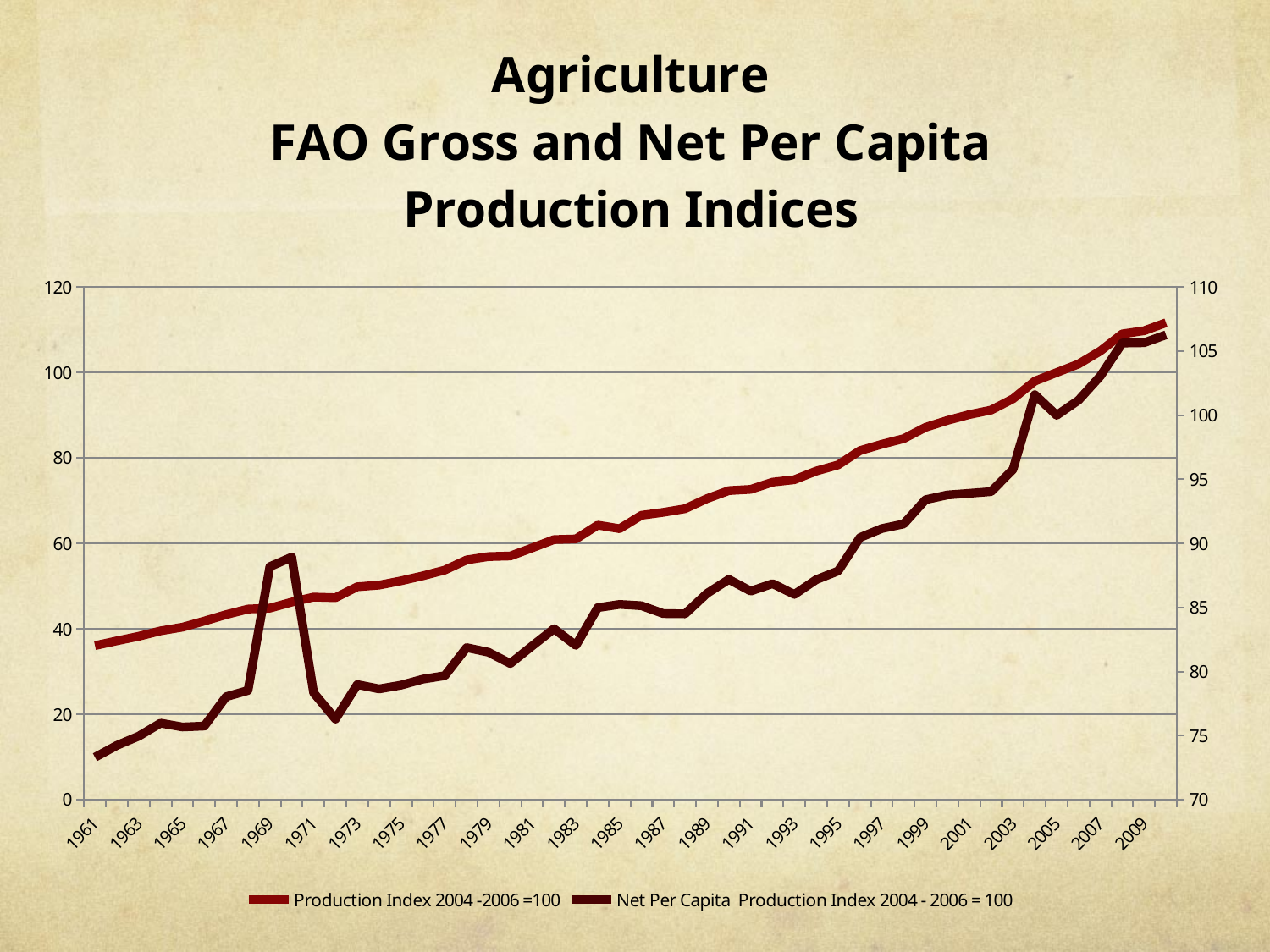
Is the value of the Net Per Capita Production Index series in 1961 greater or less than 80? less Is the value of the Production Index 2004-2006=100 series in 2009 greater or less than 100? greater Does the Production Index 2004-2006=100 series generally rise or fall from 1961 to 2009? rise Is the value of the Net Per Capita Production Index series in 2009 greater or less than 100? greater How many series does the legend list? 2 Does the Net Per Capita Production Index series generally rise or fall over the period shown? rise What is the title of the chart? Agriculture FAO Gross and Net Per Capita Production Indices In which year does the Net Per Capita Production Index series reach its lowest point? 1961 What are the two series named in the legend? Production Index 2004 -2006 =100; Net Per Capita Production Index 2004 - 2006 = 100 What kind of chart is shown on the slide? line chart How many year labels are shown on the x axis? 25